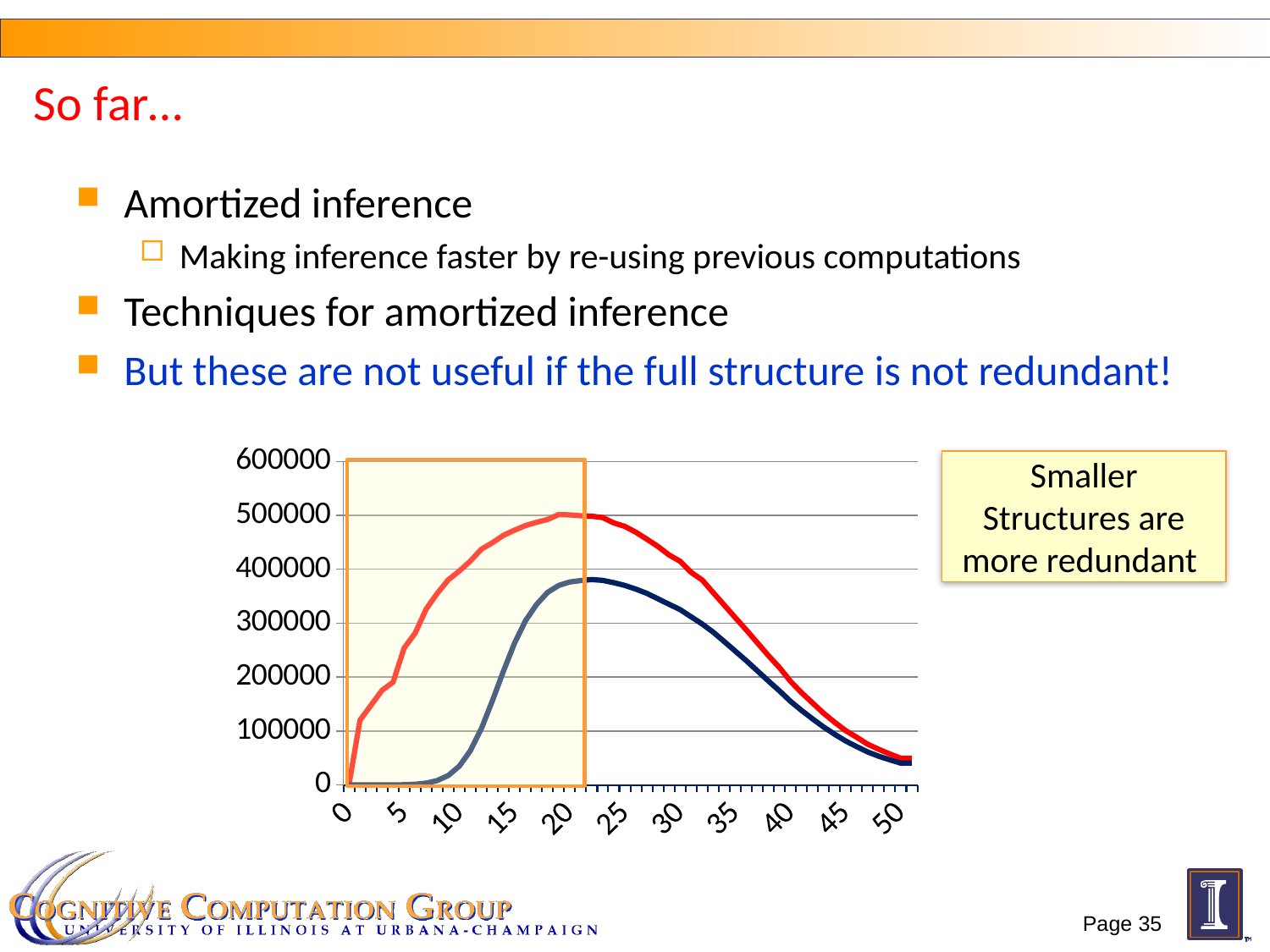
Is the value of the red line at x = 50 greater or less than 100000? less What is the largest value labelled on the horizontal axis of the chart? 50 What is the highest value shown on the vertical axis of the chart? 600000 Is the peak value of the dark blue line greater or less than 400000? less Is the value of the red line at x = 10 greater or less than 300000? greater Do the values of the red line rise or fall between x = 25 and x = 50? fall What kind of chart is shown on the slide? line chart How many lines are plotted on the chart? 2 Which line reaches the higher peak, the red line or the dark blue line? the red line Which line is higher at x = 10, the red line or the dark blue line? the red line